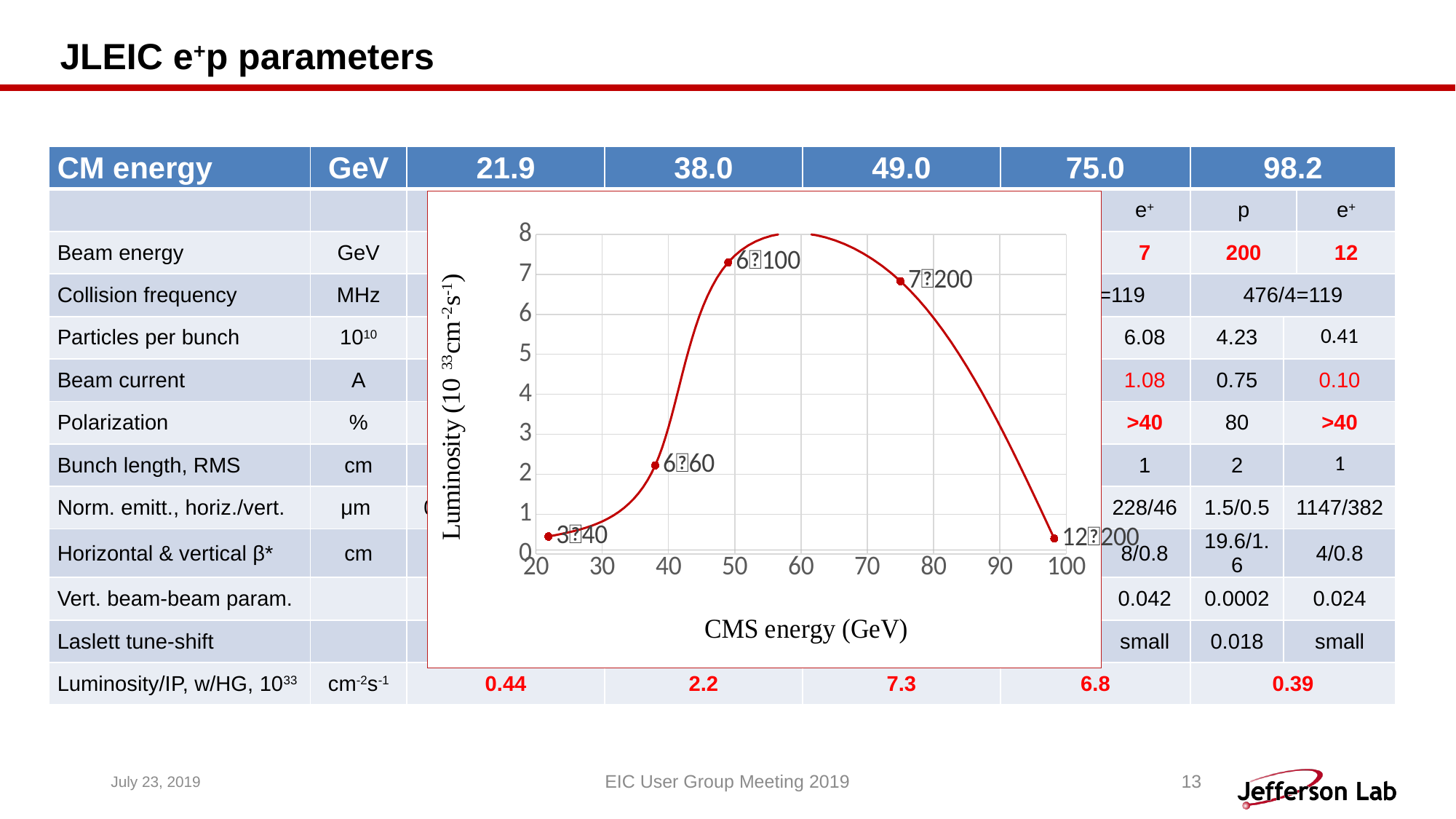
Which has the higher luminosity on the chart: the point near 49 GeV or the point near 75 GeV? the point near 49 GeV What kind of chart is shown on the slide? line chart Which labelled point on the chart has the highest luminosity? 6×100 (near 49 GeV) Is the luminosity of the point near 38 GeV CMS energy greater or less than 2? greater Is the luminosity of the point near 22 GeV CMS energy greater or less than 1? less Is the luminosity of the point near 75 GeV CMS energy greater or less than 7? less Does the luminosity curve rise or fall as CMS energy increases from 60 GeV to 100 GeV? fall How many data points are marked on the luminosity curve? 5 What quantity is plotted on the y axis of the chart? Luminosity (10^33 cm^-2 s^-1) What is the title of the x axis of the chart? CMS energy (GeV)